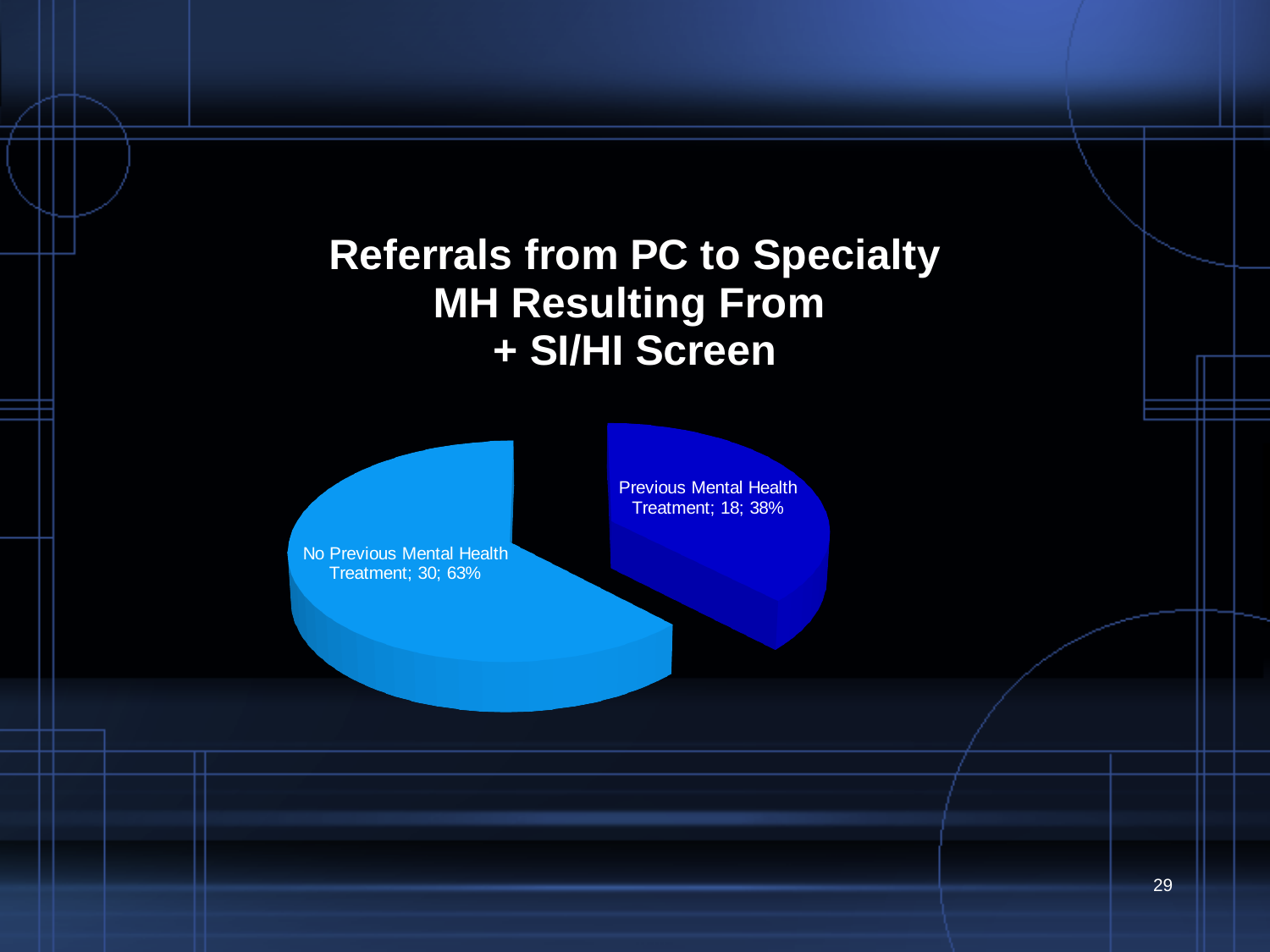
What is the difference between the values for No Previous Mental Health Treatment and Previous Mental Health Treatment? 12 What share of the pie does Previous Mental Health Treatment represent? 38% How many slices does the pie chart have? 2 What is the total of the two slice values? 48 What is the value for Previous Mental Health Treatment? 18 What is the title of the chart? Referrals from PC to Specialty MH Resulting From + SI/HI Screen Which category has the largest slice? No Previous Mental Health Treatment Which category has the smallest slice? Previous Mental Health Treatment Which is larger, the value for Previous Mental Health Treatment or No Previous Mental Health Treatment? No Previous Mental Health Treatment What is the value for No Previous Mental Health Treatment? 30 What kind of chart is shown on the slide? pie chart What share of the pie does No Previous Mental Health Treatment represent? 63%